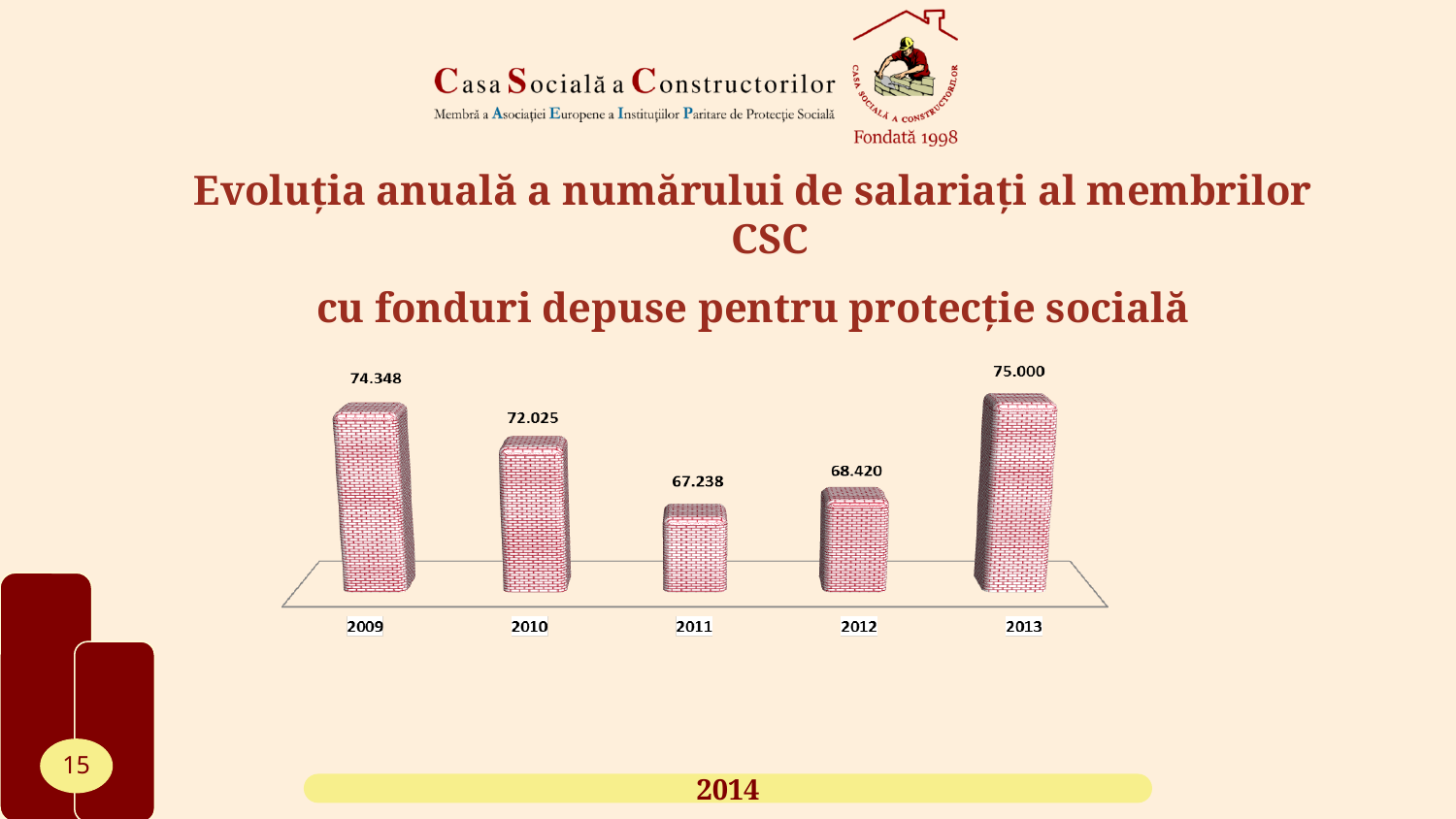
Do the values rise or fall from 2009 to 2011? Fall Which year has the lowest value? 2011 What is the difference between the values for 2009 and 2010? 2.323 What is the value shown for 2009? 74.348 How many years are shown on the x axis? 5 Which year has the highest value? 2013 What kind of chart is shown on the slide? Bar chart What is the difference between the values for 2012 and 2011? 1.182 What is the value shown for 2013? 75.000 What is the value shown for 2011? 67.238 Which is larger, the value for 2010 or the value for 2012? 2010 What year is shown in the yellow bar at the bottom of the slide? 2014